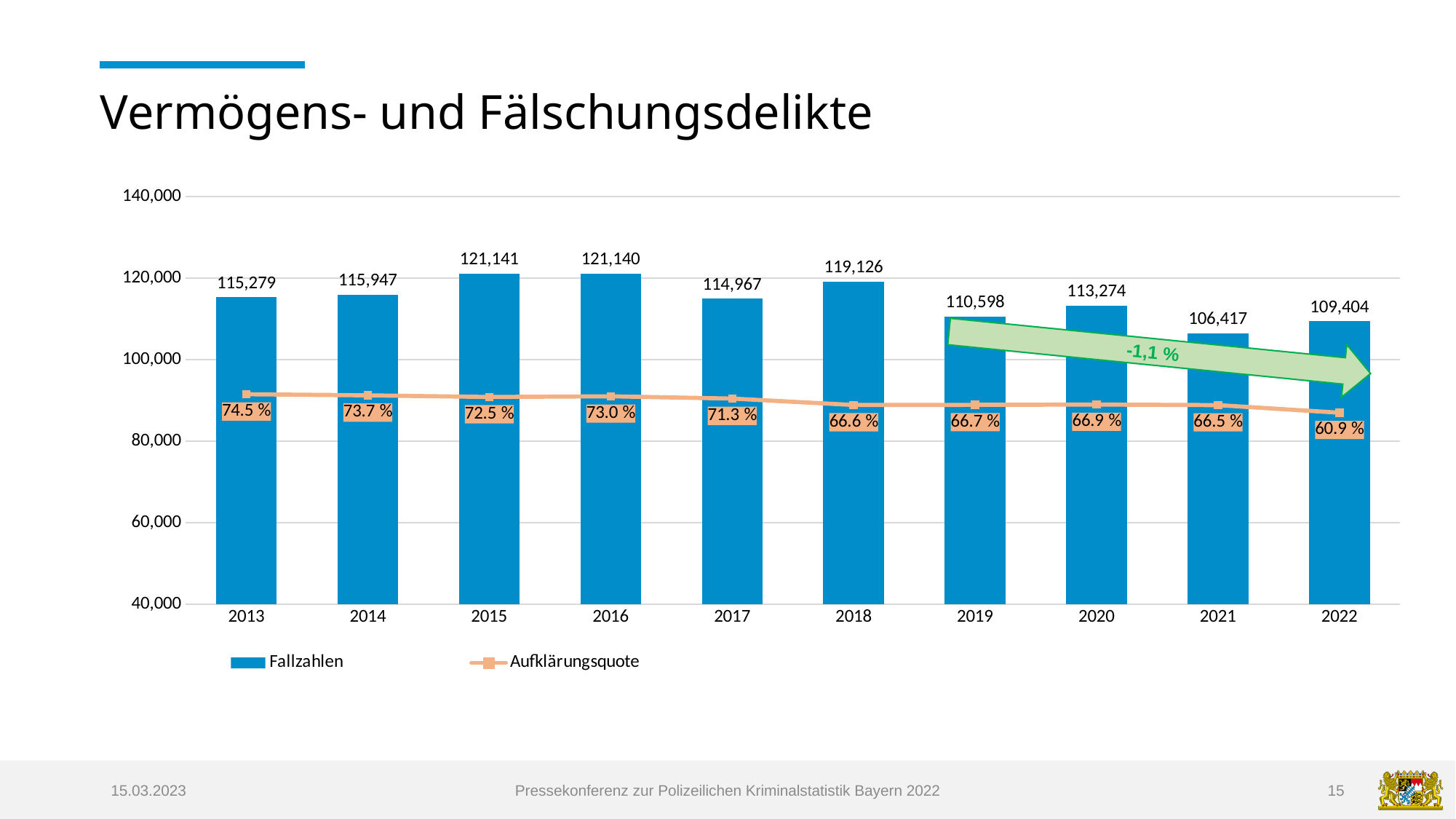
What is the Aufklärungsquote for 2022? 60.9 % Is the Fallzahlen value for 2018 greater or less than 100,000? greater Which year has the highest Aufklärungsquote? 2013 Which year has the lowest Fallzahlen value? 2021 Which year has the larger Fallzahlen value, 2019 or 2020? 2020 What is the title of the slide? Vermögens- und Fälschungsdelikte What is the Fallzahlen value for 2021? 106,417 Does the Aufklärungsquote rise or fall from 2013 to 2022? fall What is the difference between the Fallzahlen values for 2022 and 2021? 2,987 How many series does the legend list? 2 What is the Fallzahlen value for 2015? 121,141 How many years are shown on the x axis? 10